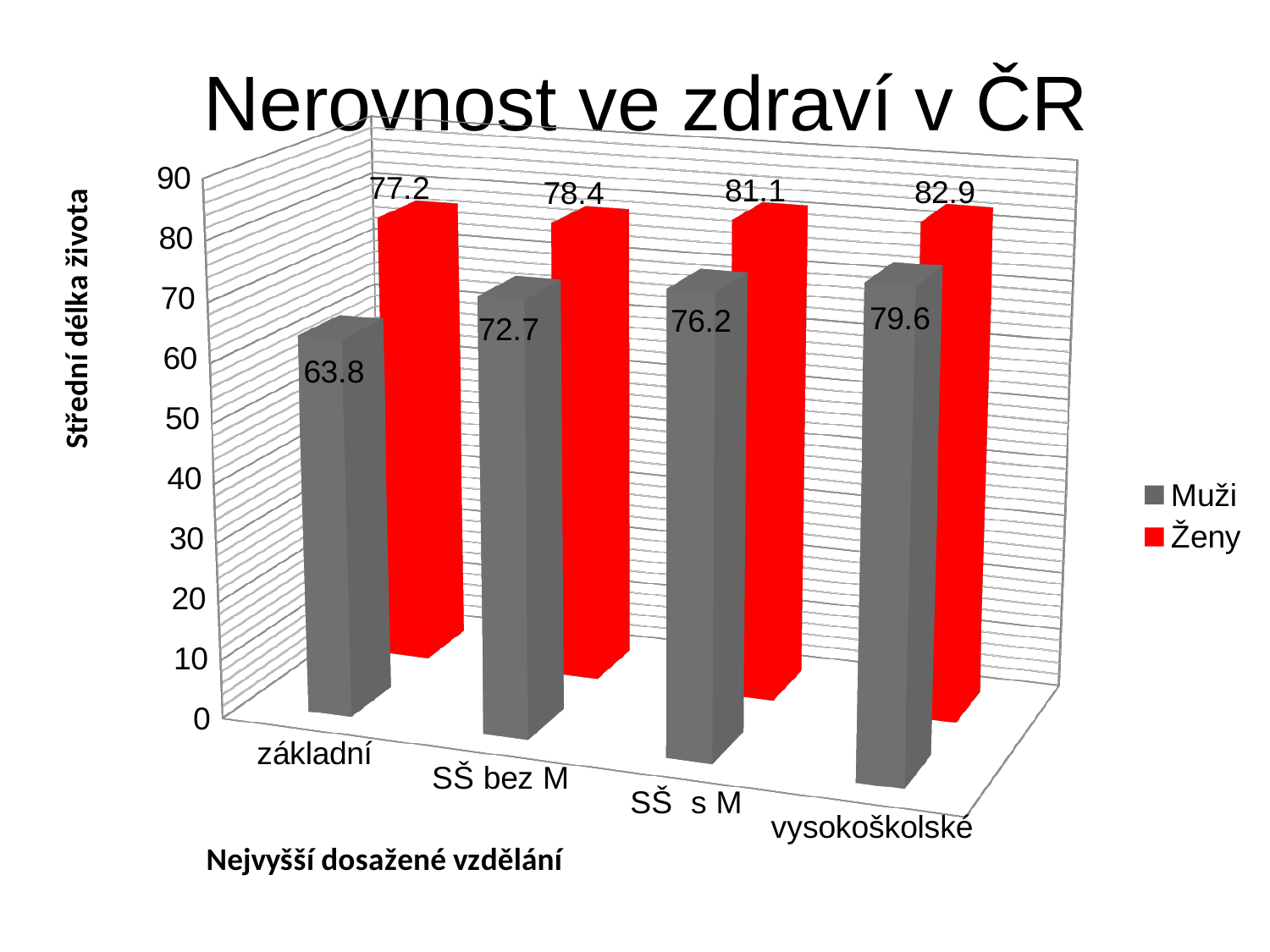
How many series does the legend list? 2 What kind of chart is shown on the slide? bar chart What is the difference between Ženy and Muži in the základní category? 13.4 Do the Muži values rise or fall from základní to vysokoškolské? rise Which category has the lowest value for Ženy? základní Which is larger: Muži for SŠ s M or Ženy for základní? Ženy for základní How many education categories are shown on the x axis? 4 What is the value for Ženy in the vysokoškolské category? 82.9 Which category has the highest value for Muži? vysokoškolské What is the difference between the Muži values for vysokoškolské and základní? 15.8 What is the value for Ženy in the SŠ bez M category? 78.4 What is the value for Muži in the základní category? 63.8